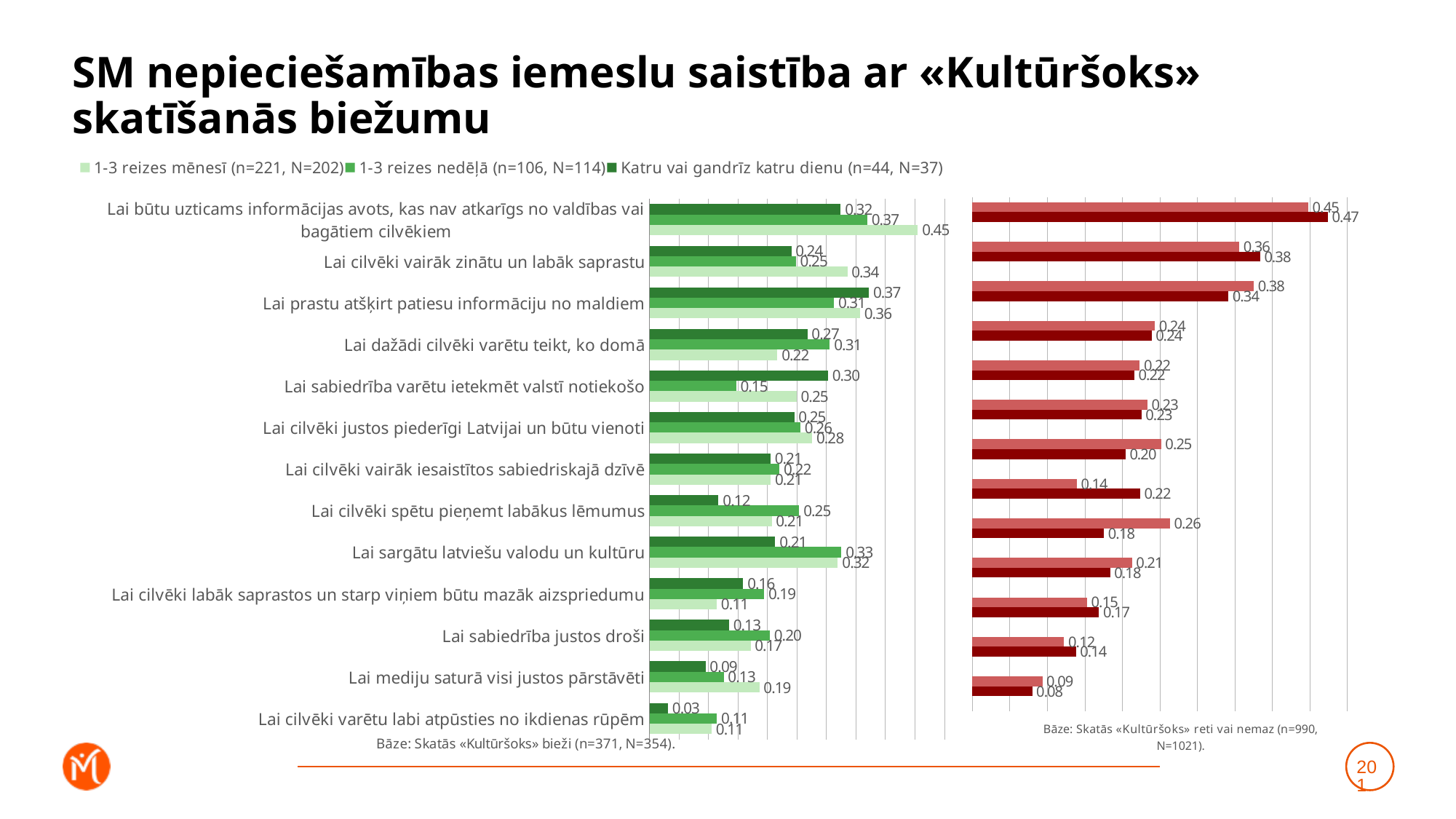
In the left (green) chart, for 'Lai dažādi cilvēki varētu teikt, ko domā', which is larger: the '1-3 reizes nedēļā' value or the '1-3 reizes mēnesī' value? 1-3 reizes nedēļā In the left (green) chart, what is the value for '1-3 reizes mēnesī' for 'Lai būtu uzticams informācijas avots, kas nav atkarīgs no valdības vai bagātiem cilvēkiem'? 0.45 In the right (red) chart, what is the value of the darker red bar for 'Lai būtu uzticams informācijas avots, kas nav atkarīgs no valdības vai bagātiem cilvēkiem'? 0.47 What kind of chart is the left (green) chart on the slide? Bar chart In the left (green) chart, which category has the lowest value for 'Katru vai gandrīz katru dienu'? Lai cilvēki varētu labi atpūsties no ikdienas rūpēm In the left (green) chart, what is the difference between the '1-3 reizes nedēļā' and 'Katru vai gandrīz katru dienu' values for 'Lai cilvēki spētu pieņemt labākus lēmumus'? 0.13 In the left (green) chart, what is the value for '1-3 reizes nedēļā' for 'Lai sargātu latviešu valodu un kultūru'? 0.33 How many categories (reasons) are shown in the left (green) chart? 13 In the right (red) chart, what is the value of the lighter red bar for 'Lai mediju saturā visi justos pārstāvēti'? 0.09 In the left (green) chart, what is the value for 'Katru vai gandrīz katru dienu' for 'Lai sabiedrība varētu ietekmēt valstī notiekošo'? 0.30 How many series does the legend of the left (green) chart list? 3 In the left (green) chart, which category has the highest value for '1-3 reizes mēnesī'? Lai būtu uzticams informācijas avots, kas nav atkarīgs no valdības vai bagātiem cilvēkiem